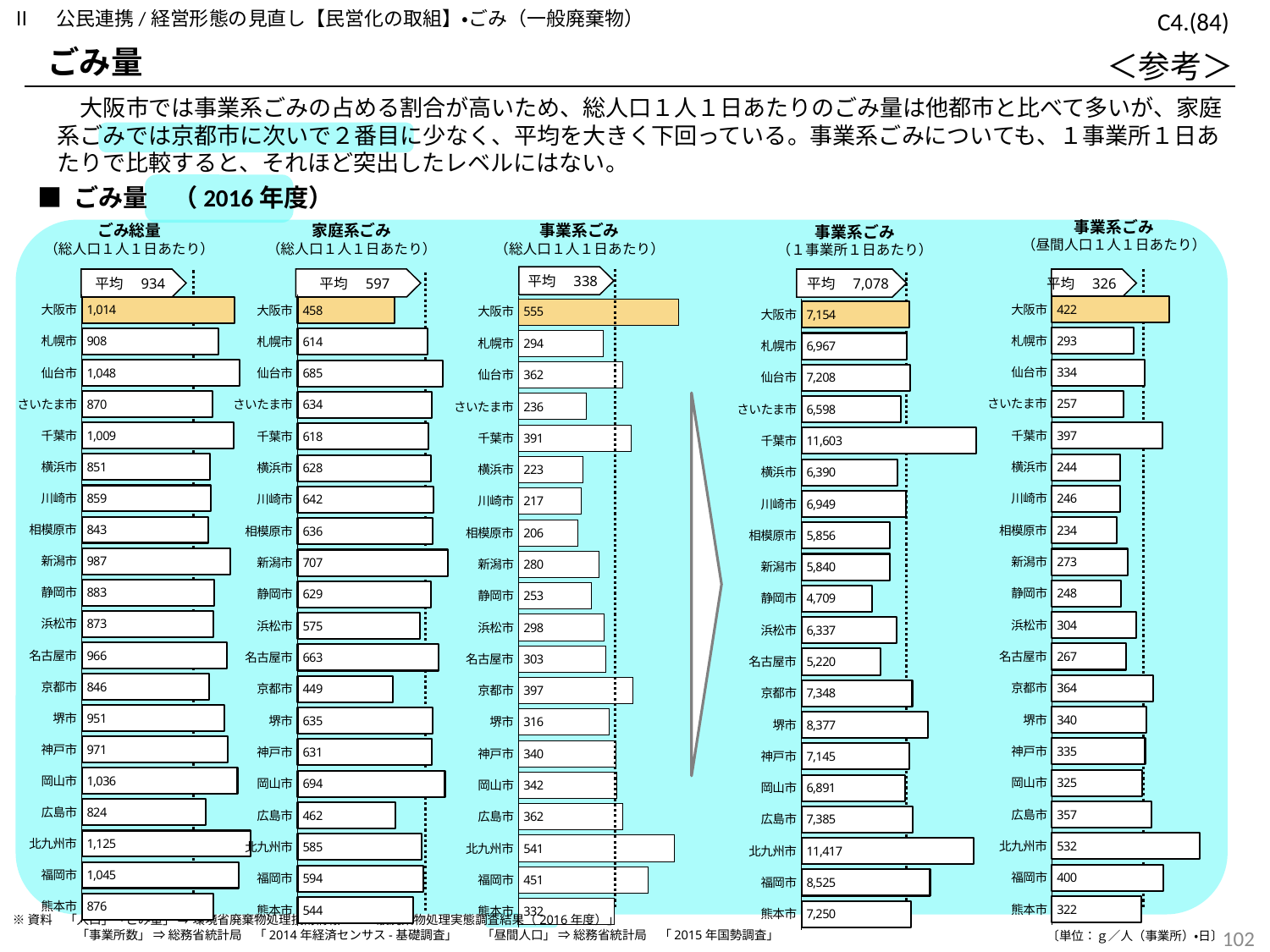
In the 事業系ごみ（1事業所1日あたり） chart, which is larger, the value for 大阪市 or the value for 堺市? 堺市 In the 家庭系ごみ（総人口1人1日あたり） chart, which city has the lowest value? 京都市 In the 家庭系ごみ（総人口1人1日あたり） chart, what is the difference between the value for 大阪市 and the value for 京都市? 9 In the 事業系ごみ（1事業所1日あたり） chart, which city has the highest value? 千葉市 In the 事業系ごみ（総人口1人1日あたり） chart, which city has the highest value? 大阪市 How many cities are shown in the 事業系ごみ（昼間人口1人1日あたり） chart? 20 What type of chart is the ごみ総量（総人口1人1日あたり） chart? Bar chart In the ごみ総量（総人口1人1日あたり） chart, which city has the highest value? 北九州市 In the 事業系ごみ（総人口1人1日あたり） chart, what is the 平均 (average) value shown? 338 In the 事業系ごみ（1事業所1日あたり） chart, which city has the lowest value? 静岡市 In the 事業系ごみ（昼間人口1人1日あたり） chart, what is the value for 北九州市? 532 In the ごみ総量（総人口1人1日あたり） chart, what is the value for 大阪市? 1,014